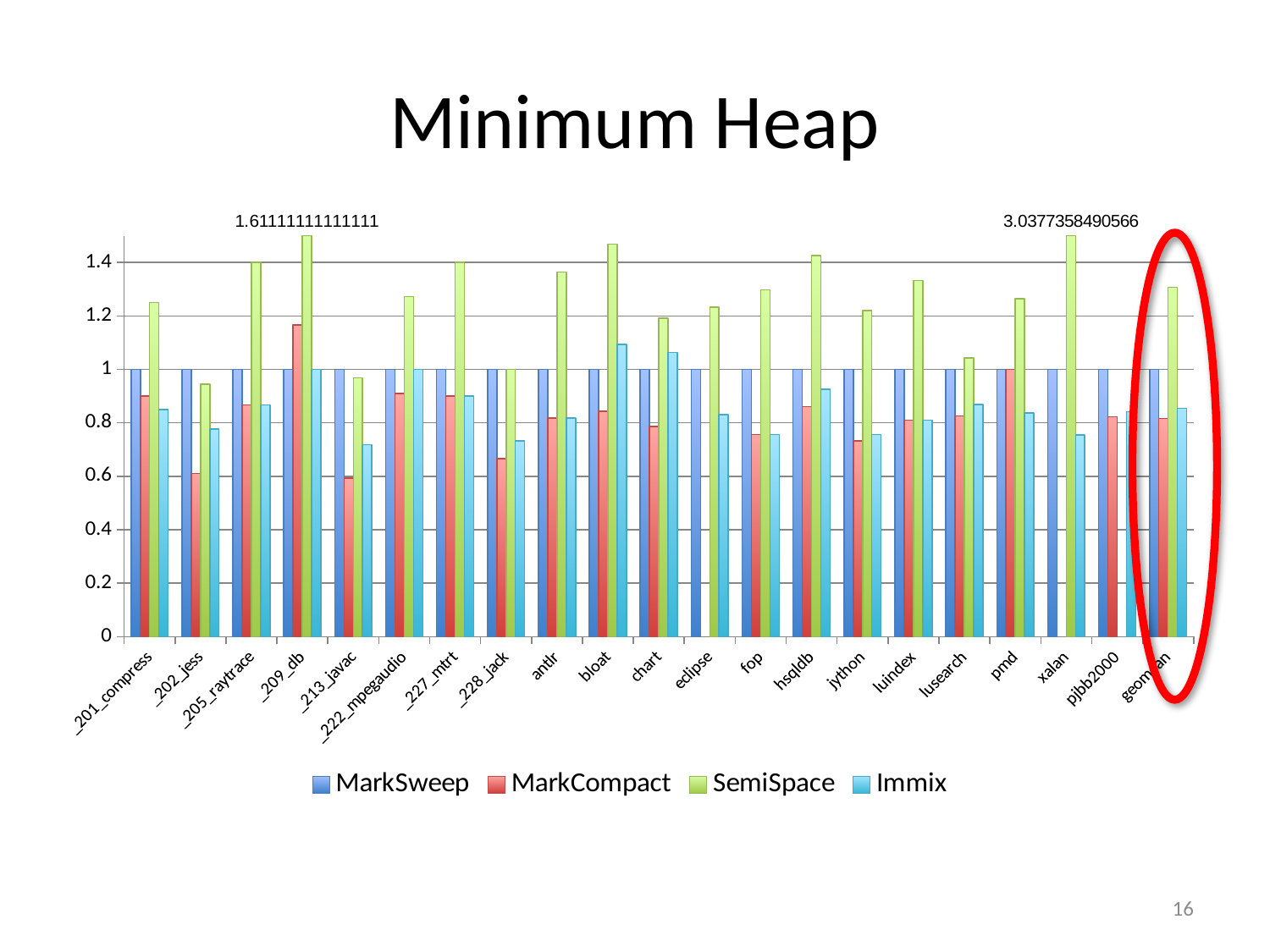
Which category has the highest SemiSpace value? xalan Is the SemiSpace value for antlr greater or less than 1.2? greater What is the SemiSpace value for _209_db? 1.61111111111111 How many series does the legend list? 4 What is the SemiSpace value for xalan? 3.0377358490566 What is the MarkSweep value for antlr? 1 Is the Immix value for _213_javac greater or less than 0.8? less Which category on the x axis is circled in red? geomean Is the Immix value for bloat greater or less than 1? greater What kind of chart is shown on the slide? bar chart For _209_db, which is larger: the MarkCompact value or the Immix value? MarkCompact How many categories are shown on the x axis? 21